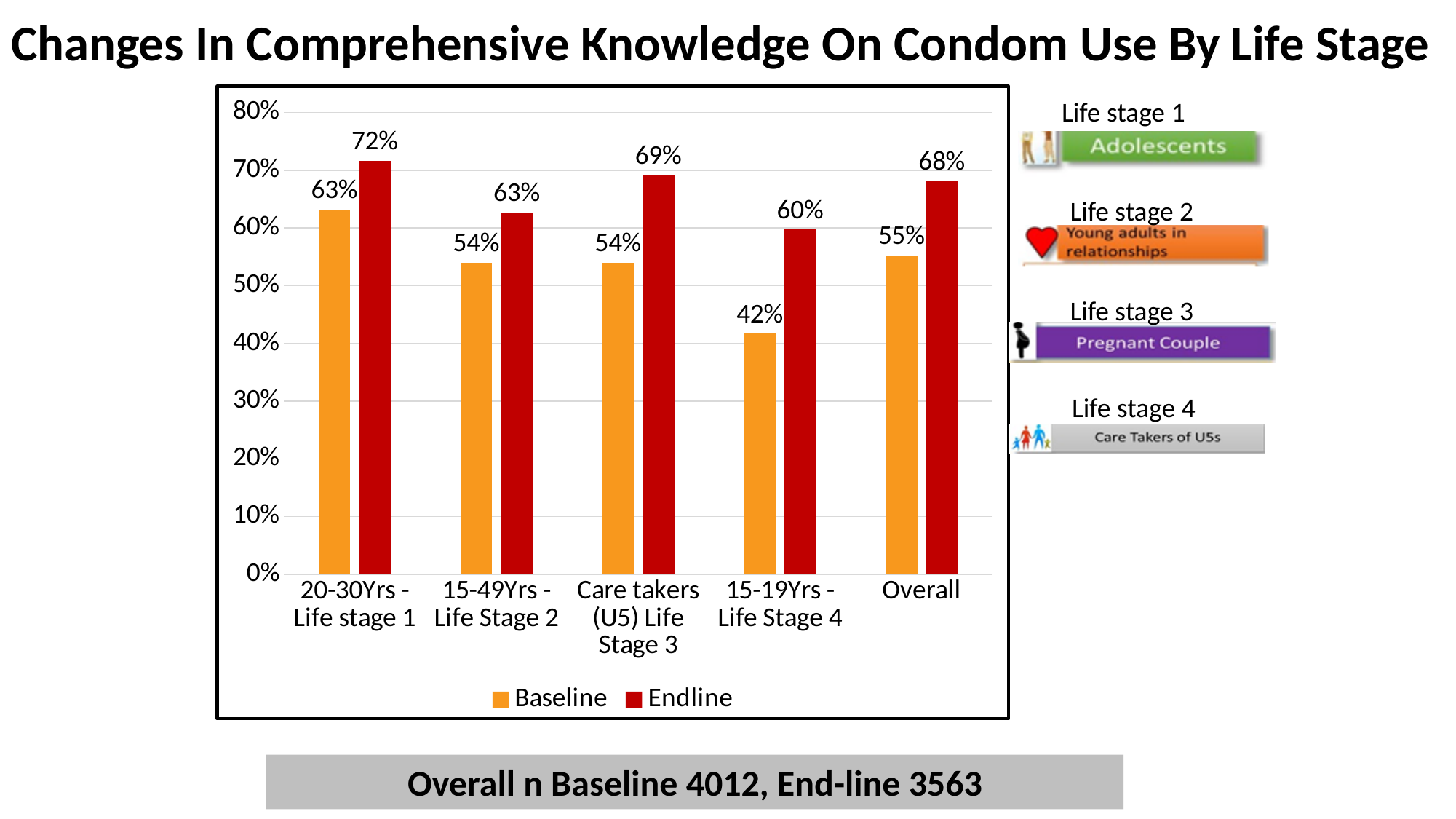
What is the Baseline value for 15-19Yrs - Life Stage 4? 42% Which category has the lowest Baseline value? 15-19Yrs - Life Stage 4 How many series does the legend list? 2 What is the Baseline value for 20-30Yrs - Life stage 1? 63% How many categories are shown on the x axis? 5 What is the Endline value for Care takers (U5) Life Stage 3? 69% What is the difference between the Endline and Baseline values for 15-19Yrs - Life Stage 4? 18% Which is larger for 15-49Yrs - Life Stage 2: the Baseline value or the Endline value? Endline What kind of chart is shown on the slide? Bar chart What is the Endline value for Overall? 68% What colour are the Endline bars? Red Which category has the highest Endline value? 20-30Yrs - Life stage 1